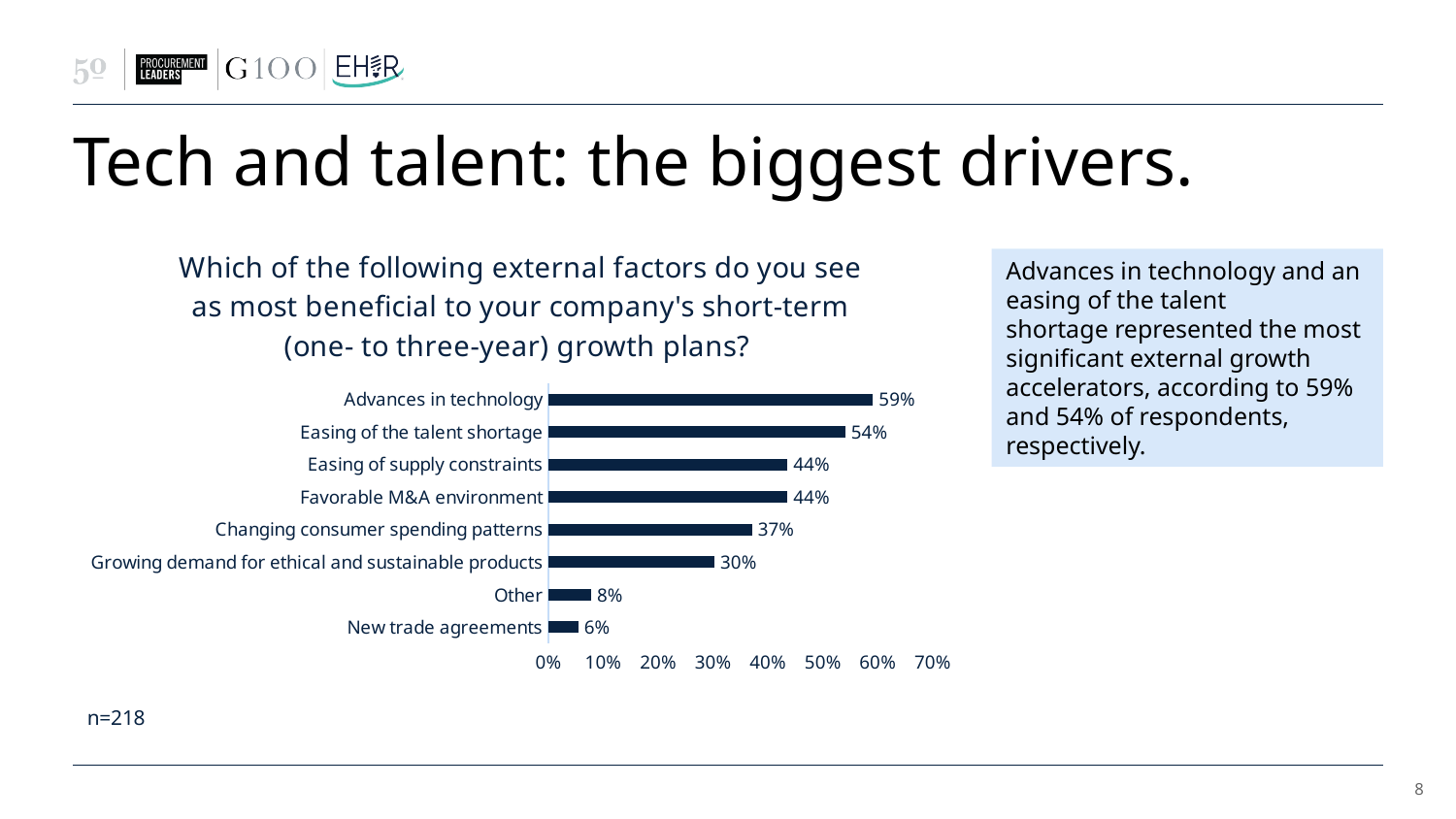
Which is larger: 'Easing of supply constraints' or 'Changing consumer spending patterns'? Easing of supply constraints What is the value for 'Changing consumer spending patterns'? 37% What percentage of respondents selected 'Advances in technology'? 59% What kind of chart is shown on the slide? Bar chart Which category has the highest value? Advances in technology What is the difference between 'Advances in technology' and 'Easing of the talent shortage'? 5% Is the value for 'Easing of the talent shortage' greater or less than 50%? greater What is the difference between 'Other' and 'New trade agreements'? 2% Which category has the lowest value? New trade agreements What is the value for 'Growing demand for ethical and sustainable products'? 30% What is the sample size (n) noted on the slide? n=218 How many categories are shown in the chart? 8